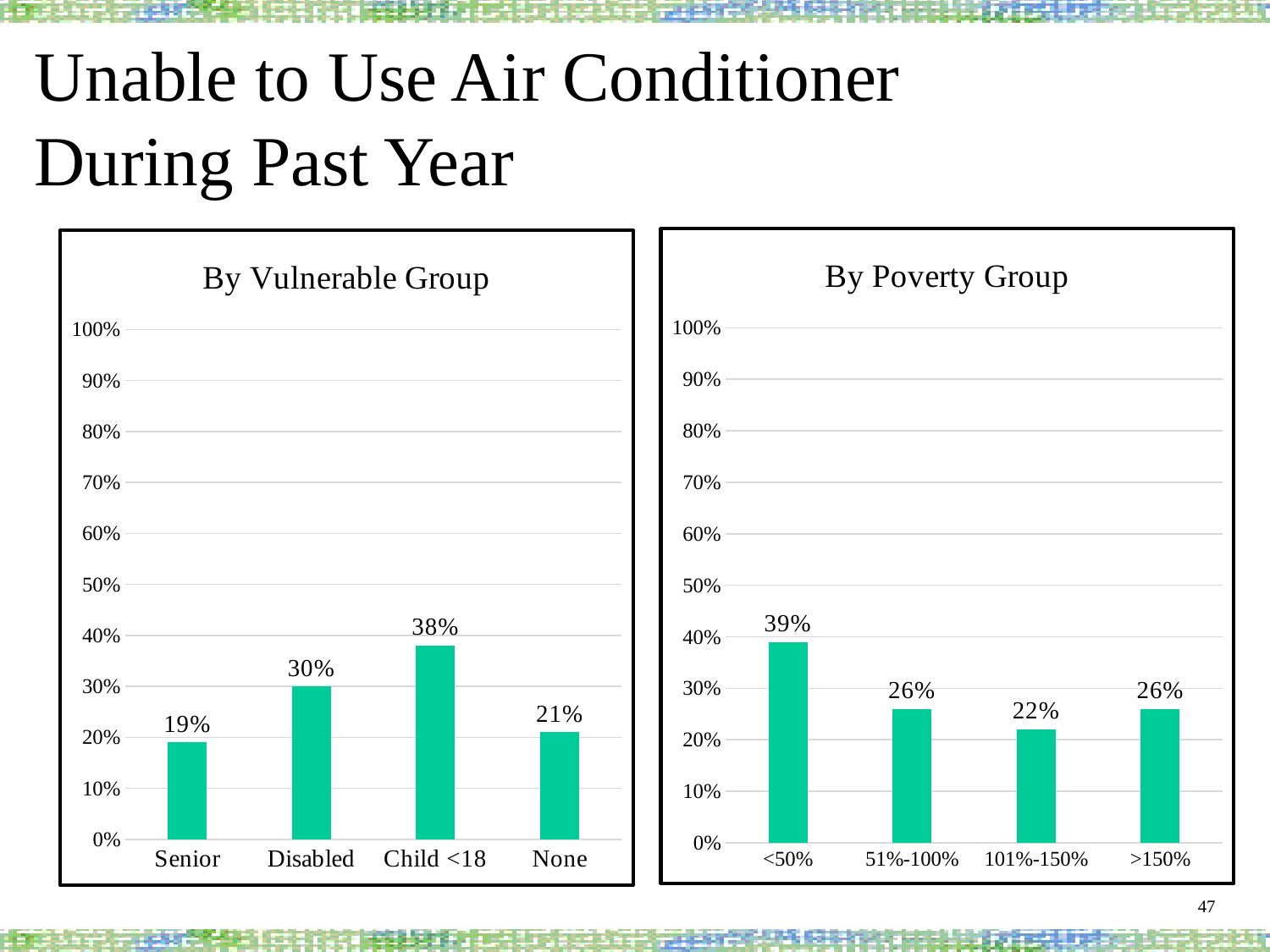
In the 'By Poverty Group' chart, what is the value for 101%-150%? 22% In the 'By Vulnerable Group' chart, which is larger, the value for Disabled or the value for None? Disabled In the 'By Poverty Group' chart, what is the difference between the values for <50% and 51%-100%? 13% What kind of chart is the 'By Vulnerable Group' chart? Bar chart In the 'By Vulnerable Group' chart, which category has the highest value? Child <18 What is the title of the chart on the right side of the slide? By Poverty Group In the 'By Vulnerable Group' chart, what is the value for Disabled? 30% In the 'By Poverty Group' chart, which category has the highest value? <50% In the 'By Vulnerable Group' chart, which category has the lowest value? Senior In the 'By Vulnerable Group' chart, what is the difference between the values for Child <18 and Senior? 19% In the 'By Poverty Group' chart, which category has the lowest value? 101%-150% How many categories are shown in the 'By Poverty Group' chart? 4